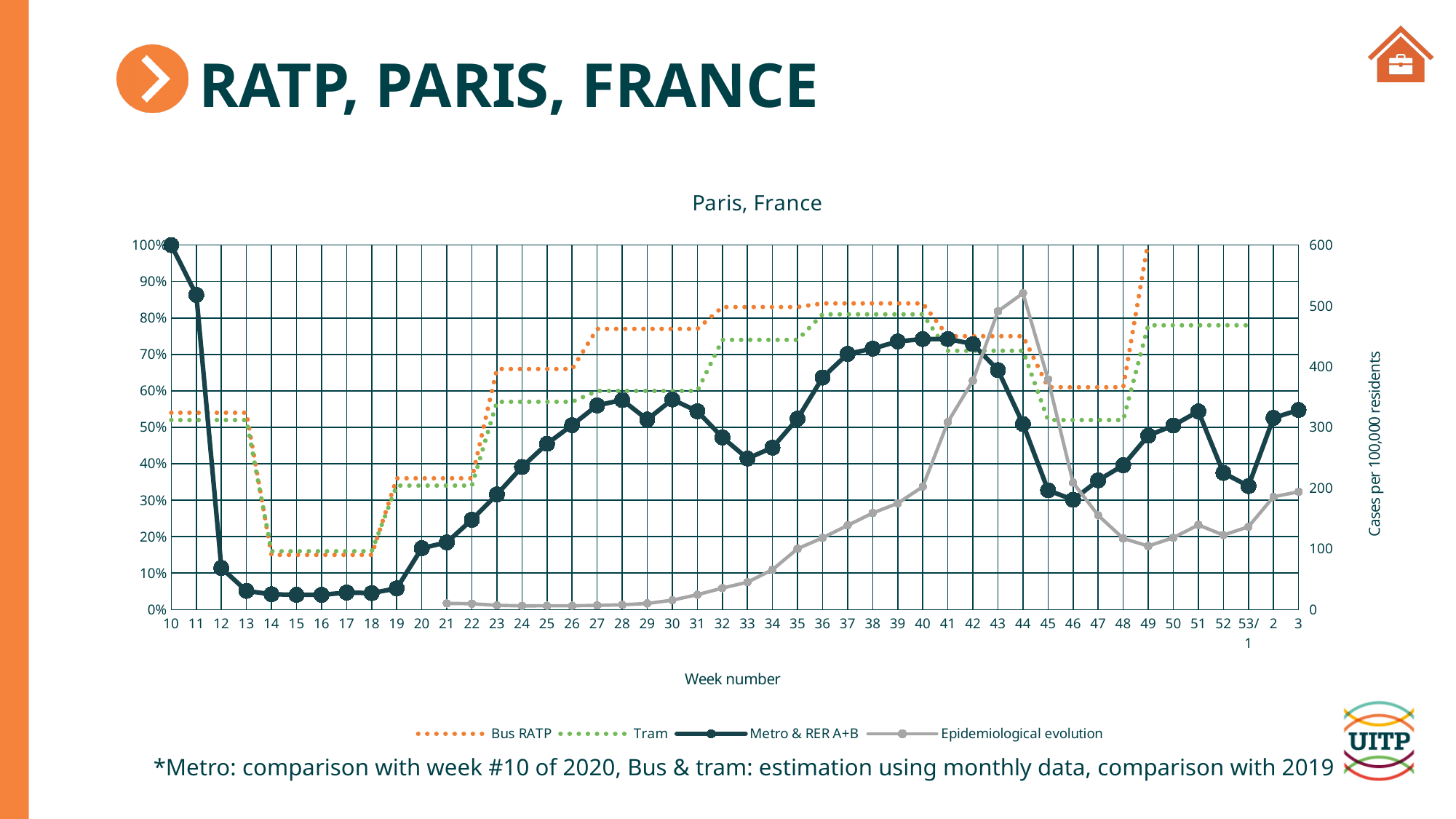
At which week does the Epidemiological evolution series reach its peak? 44 Which is larger at week 32, the Bus RATP value or the Tram value? Bus RATP Is the Metro & RER A+B value at week 12 greater or less than 20%? less What is the Metro & RER A+B value at week 10? 100% Is the Bus RATP value at week 14 greater or less than 20%? less At which week is the Metro & RER A+B series highest? 10 Does the Epidemiological evolution series rise or fall between week 44 and week 48? fall What kind of chart is shown on the slide? line chart What is the title of the chart? Paris, France How many series does the legend list? 4 Is the Epidemiological evolution value at week 44 greater or less than 500? greater What is the label of the right-hand vertical axis? Cases per 100,000 residents